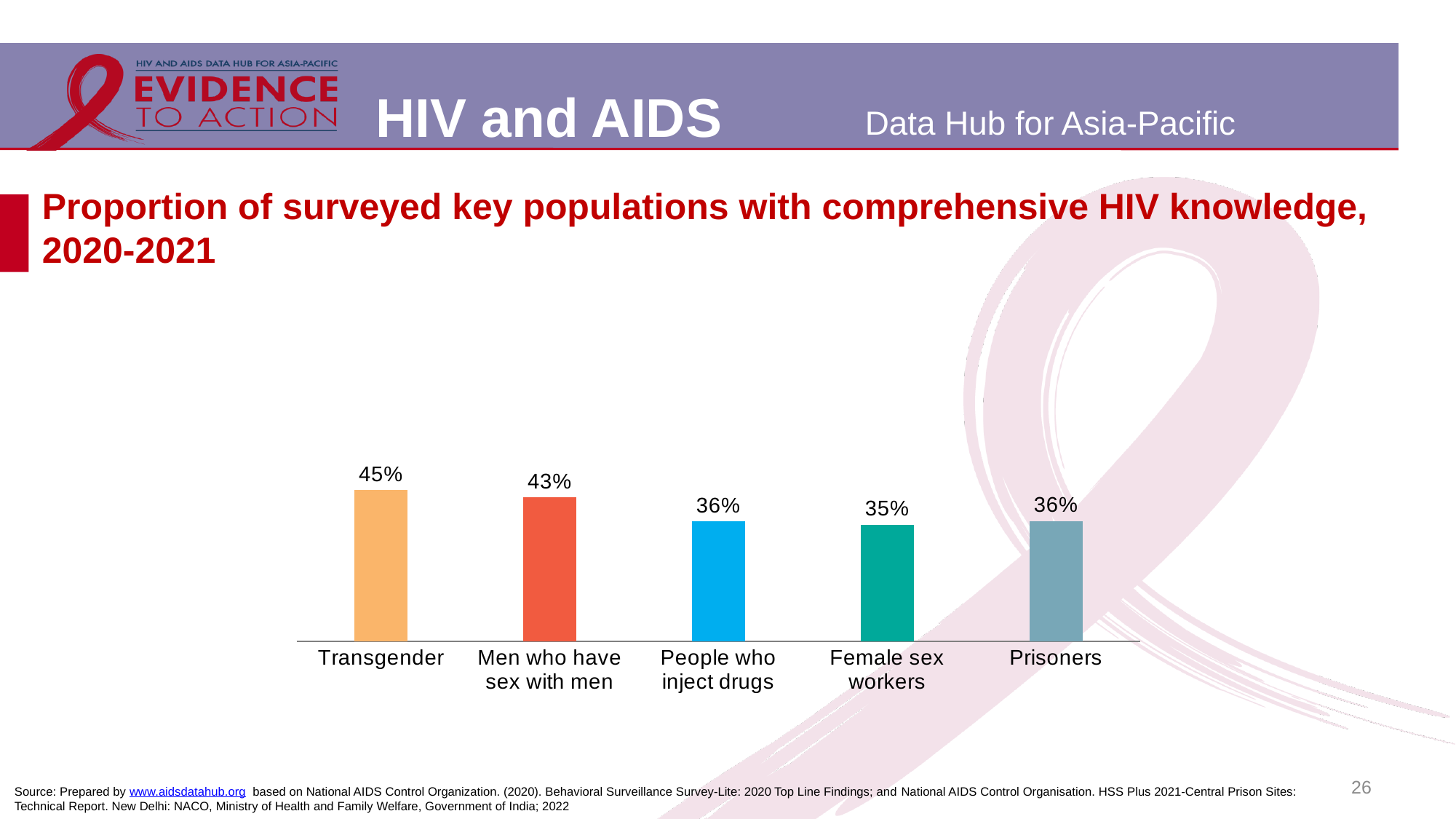
What is the value shown for men who have sex with men? 43% What is the proportion of surveyed transgender people with comprehensive HIV knowledge? 45% Which key population has the lowest proportion with comprehensive HIV knowledge? Female sex workers What is the value shown for prisoners? 36% What is the value shown for female sex workers? 35% How many key populations are shown in the chart? 5 What kind of chart is shown on the slide? Bar chart Which key population has the highest proportion with comprehensive HIV knowledge? Transgender What is the value shown for people who inject drugs? 36% What is the difference between the values for transgender people and female sex workers? 10 percentage points Which is larger, the value for men who have sex with men or the value for prisoners? Men who have sex with men What is the difference between the values for transgender people and men who have sex with men? 2 percentage points